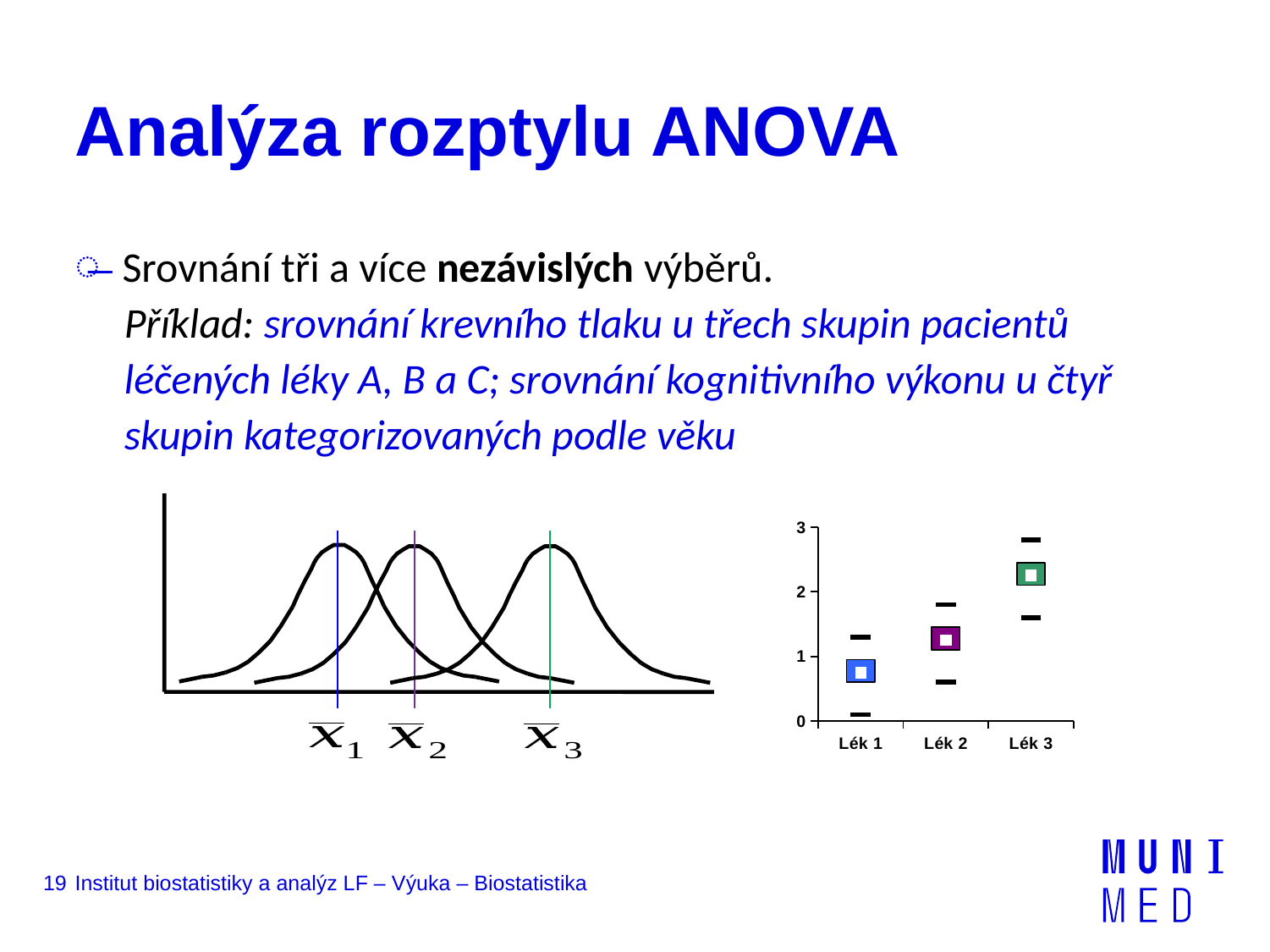
In the chart on the right, which has the larger central value, Lék 1 or Lék 3? Lék 3 In the chart on the right, is the central value for Lék 1 greater or less than 1? less In the chart on the right, how many categories are shown on the x axis? 3 In the chart on the right, which category has the highest central value? Lék 3 In the chart on the right, which category has the lowest central value? Lék 1 In the chart on the right, do the central values rise or fall from Lék 1 to Lék 3? rise In the chart on the right, is the central value for Lék 3 greater or less than 2? greater In the chart on the right, which has the larger central value, Lék 2 or Lék 1? Lék 2 In the chart on the right, what is the highest value shown on the y axis? 3 In the chart on the right, is the central value for Lék 2 greater or less than 1? greater In the chart on the right, what are the labels of the three categories on the x axis? Lék 1, Lék 2, Lék 3